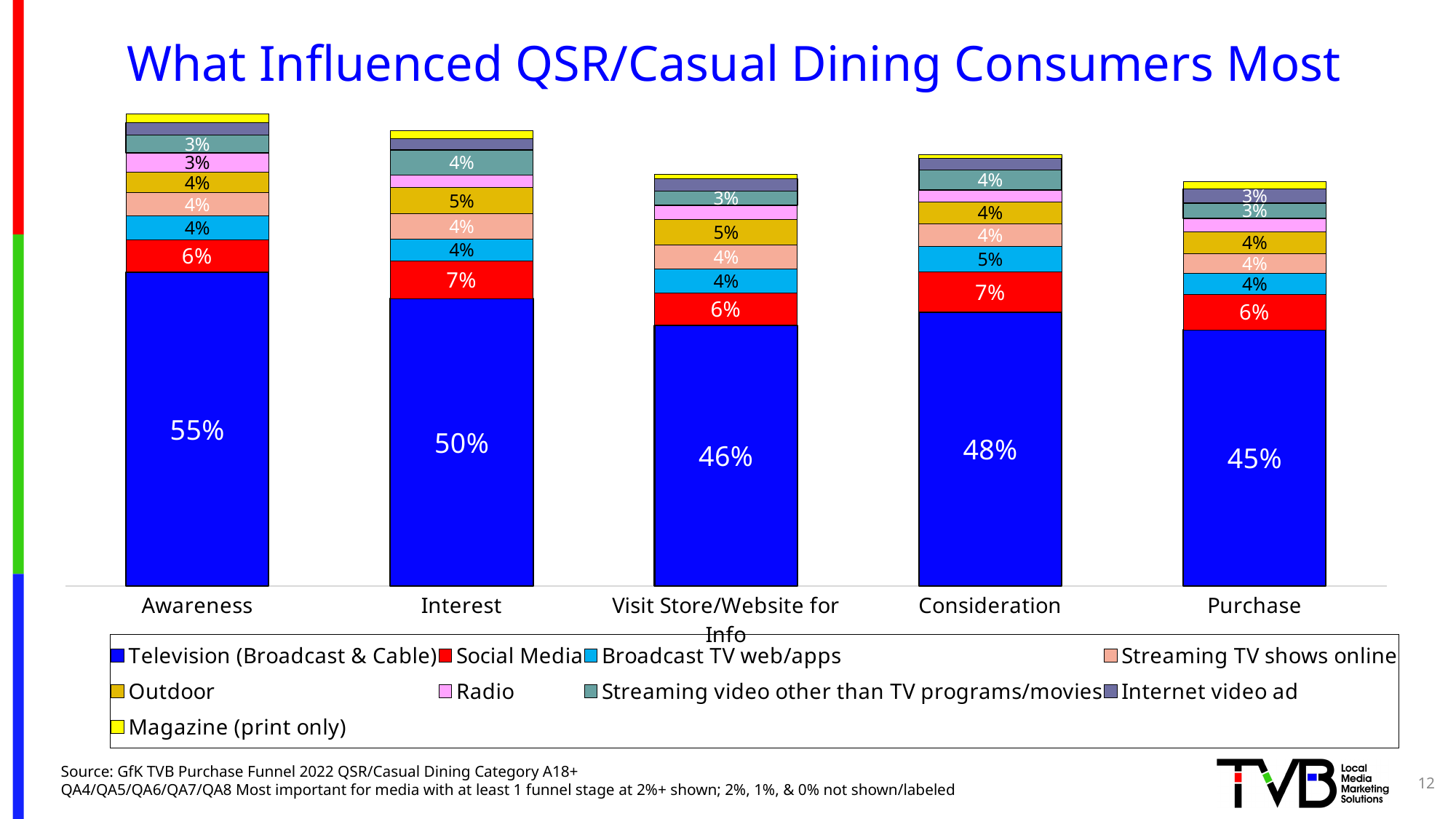
What percentage of the Awareness bar is Television (Broadcast & Cable)? 55% What is the Outdoor value for the Interest stage? 5% Which funnel stage has the highest Television (Broadcast & Cable) share? Awareness How many percentage points higher is the Television share for Awareness than for Purchase? 10 percentage points What kind of chart is shown on the slide? Stacked bar chart How many media series does the legend list? 9 What is the Broadcast TV web/apps value for the Consideration stage? 5% How many funnel stages are shown along the x axis? 5 Which funnel stage has the lowest Television (Broadcast & Cable) share? Purchase Is the Social Media value larger for Interest or for Visit Store/Website for Info? Interest What is the Social Media value for the Consideration stage? 7% Does the Television (Broadcast & Cable) share rise or fall from Awareness to Interest? Fall